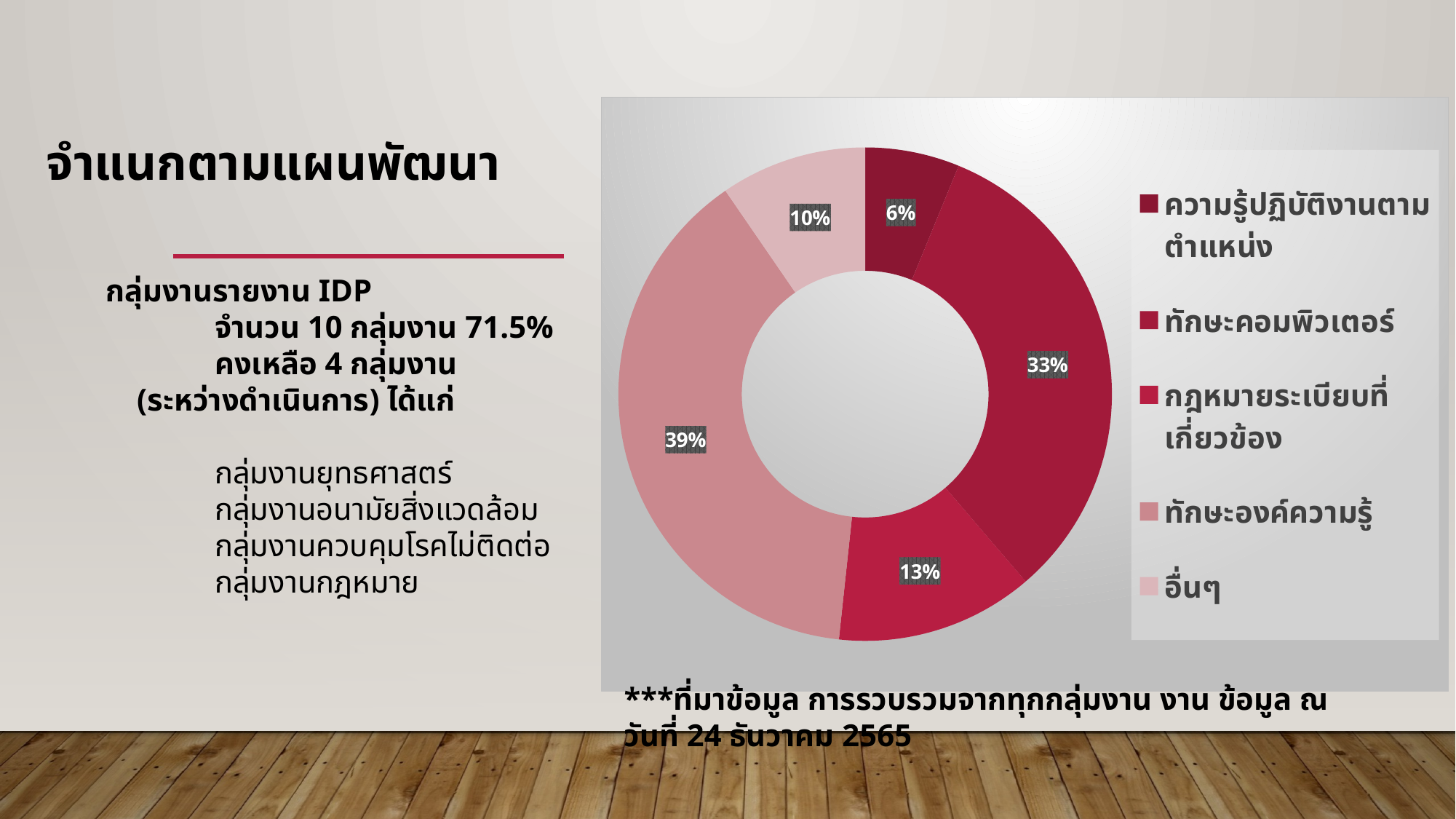
What percentage is shown for กฎหมายระเบียบที่เกี่ยวข้อง? 13% How many categories does the donut chart show? 5 How many entries does the legend list? 5 What percentage does the slice for ทักษะองค์ความรู้ show? 39% What percentage is shown for อื่นๆ? 10% Which category has the largest share of the donut chart? ทักษะองค์ความรู้ Which is larger, the share for กฎหมายระเบียบที่เกี่ยวข้อง or the share for อื่นๆ? กฎหมายระเบียบที่เกี่ยวข้อง What kind of chart is shown on the slide? Donut (pie) chart What percentage of the donut chart is labelled for ทักษะคอมพิวเตอร์? 33% Which category has the smallest share of the donut chart? ความรู้ปฏิบัติงานตามตำแหน่ง What is the difference in percentage points between ทักษะองค์ความรู้ and ทักษะคอมพิวเตอร์? 6 What is the combined share of ทักษะคอมพิวเตอร์ and ความรู้ปฏิบัติงานตามตำแหน่ง? 39%